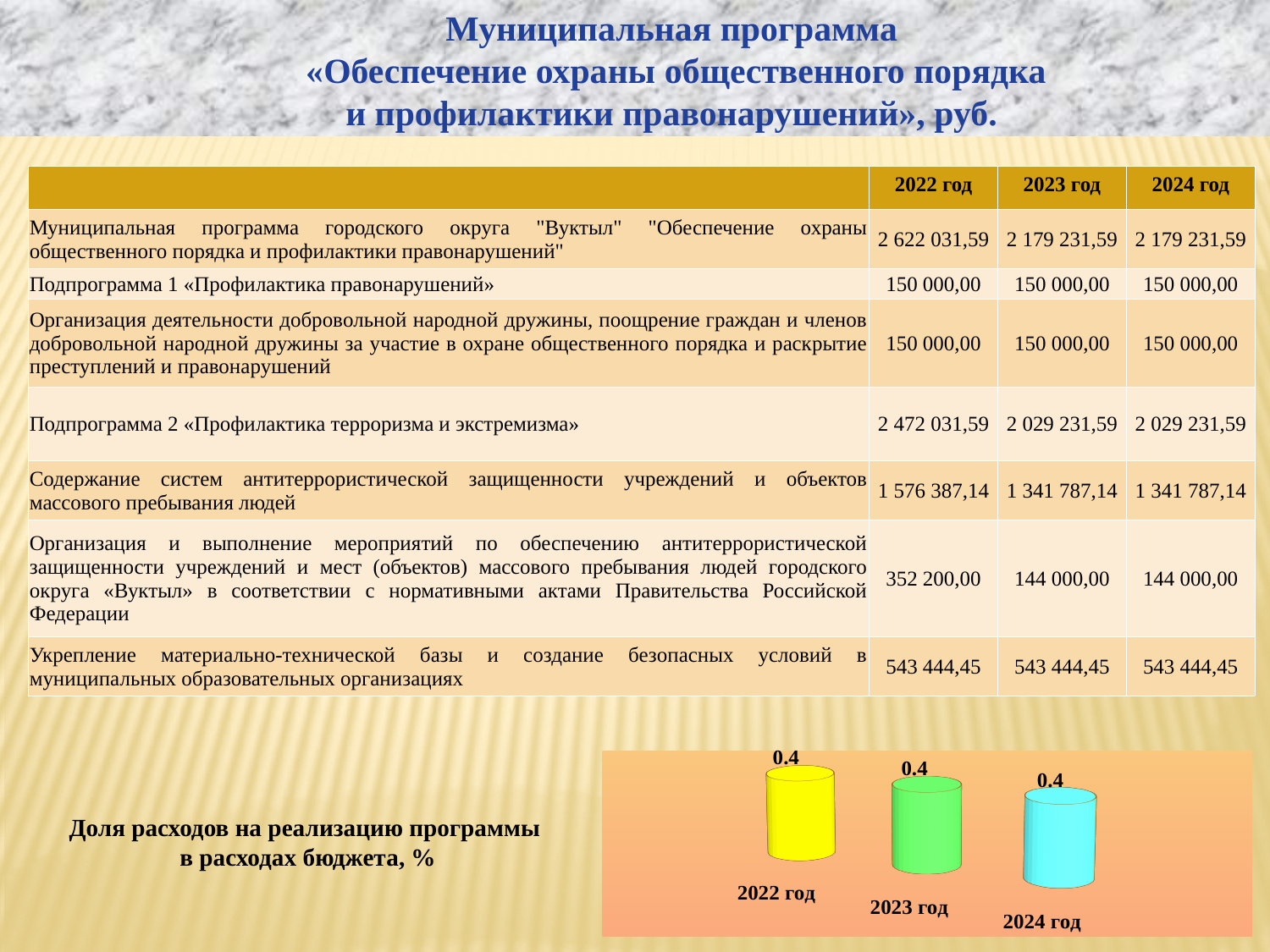
What is the value for 2022 год in the chart? 0.4 What colour is the bar for 2022 год in the chart? yellow How many categories are shown in the chart? 3 What is the value for 2023 год in the chart? 0.4 Do the values in the chart rise, fall or stay the same from 2022 год to 2024 год? stay the same What does the text next to the chart say it shows? Доля расходов на реализацию программы в расходах бюджета, % What is the difference between the values for 2022 год and 2024 год in the chart? 0 Is the value for 2023 год in the chart greater or less than 1? less What is the value for 2024 год in the chart? 0.4 What kind of chart is shown at the bottom of the slide? bar chart